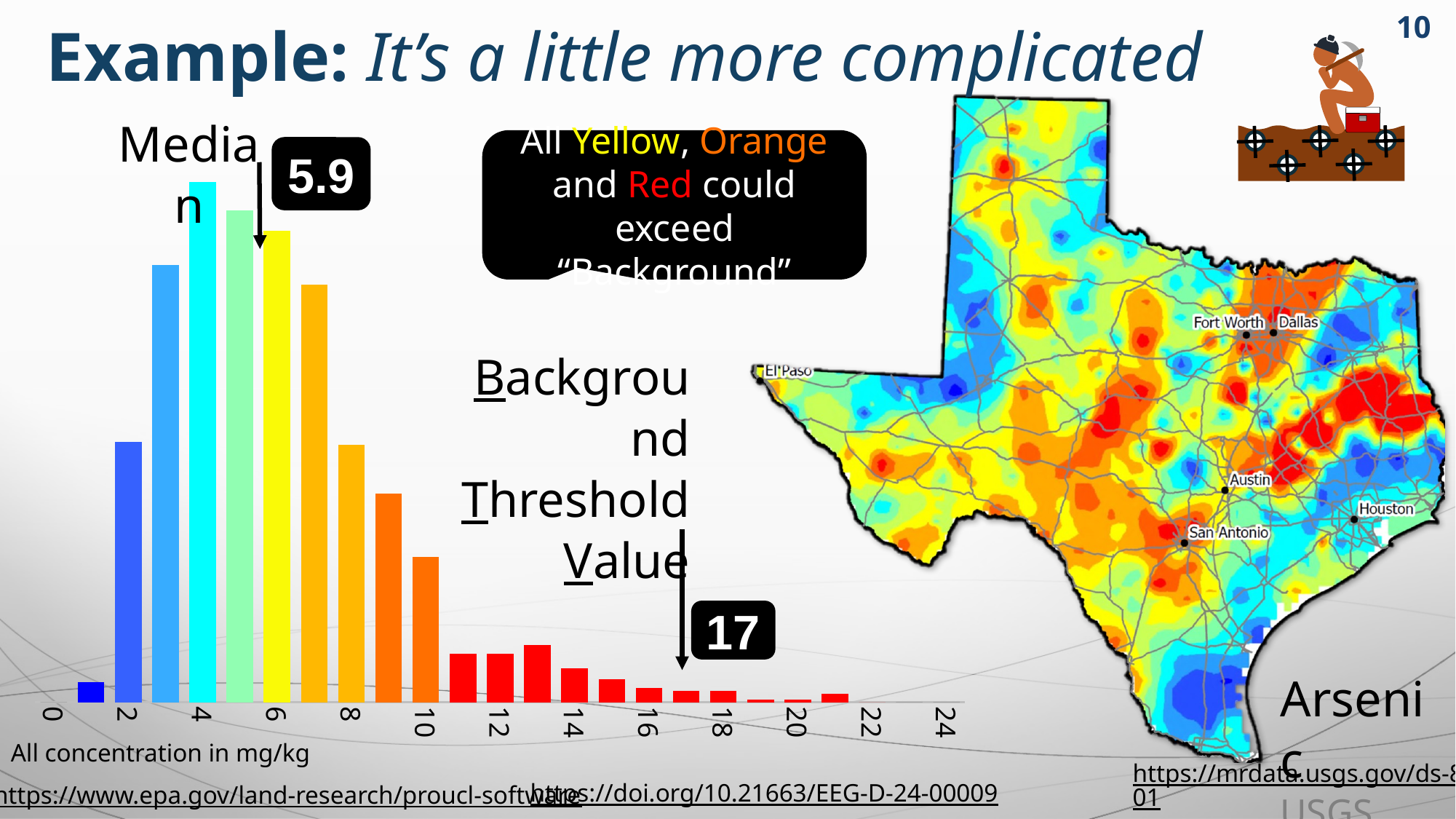
What is the median value marked on the bar chart? 5.9 What kind of chart is shown on the left of the slide? bar chart What is the difference between the Background Threshold Value and the median marked on the bar chart? 11.1 What is the highest tick value shown on the bar chart's x axis? 24 On the bar chart, do the bar heights rise or fall as the x axis goes from 6 to 20 mg/kg? fall On the bar chart, which bar is taller: the one near 10 mg/kg or the one near 14 mg/kg? the one near 10 mg/kg What unit are the concentrations on the bar chart's x axis given in? mg/kg What is the Background Threshold Value marked on the bar chart? 17 Near which x-axis tick does the tallest bar of the bar chart sit? 4 Is the Background Threshold Value on the bar chart greater or less than 16? greater Is the median value on the bar chart greater or less than 6? less On the bar chart, which bar is taller: the one near 4 mg/kg or the one near 12 mg/kg? the one near 4 mg/kg